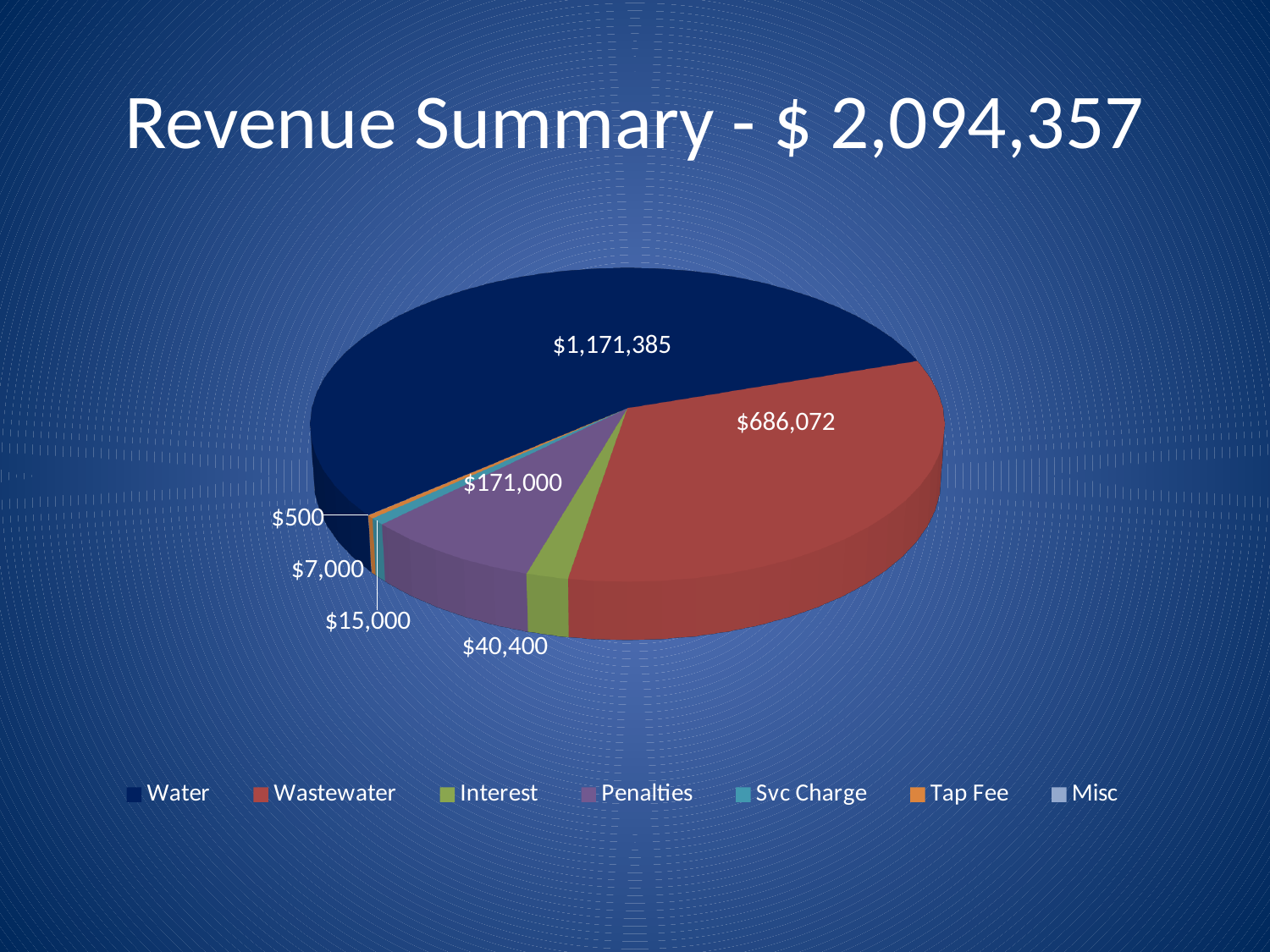
What is the value of the Penalties slice? $171,000 What kind of chart is shown on the slide? Pie chart What is the difference between the Water and Wastewater values? $485,313 What is the value of the Water slice? $1,171,385 What is the difference between the Penalties and Interest values? $130,600 How many categories does the legend list? 7 What is the title of the chart slide? Revenue Summary - $ 2,094,357 Which category has the largest slice of the pie? Water What is the value of the Interest slice? $40,400 Which is larger, Penalties or Interest? Penalties Which category has the smallest slice of the pie? Misc What is the value of the Wastewater slice? $686,072